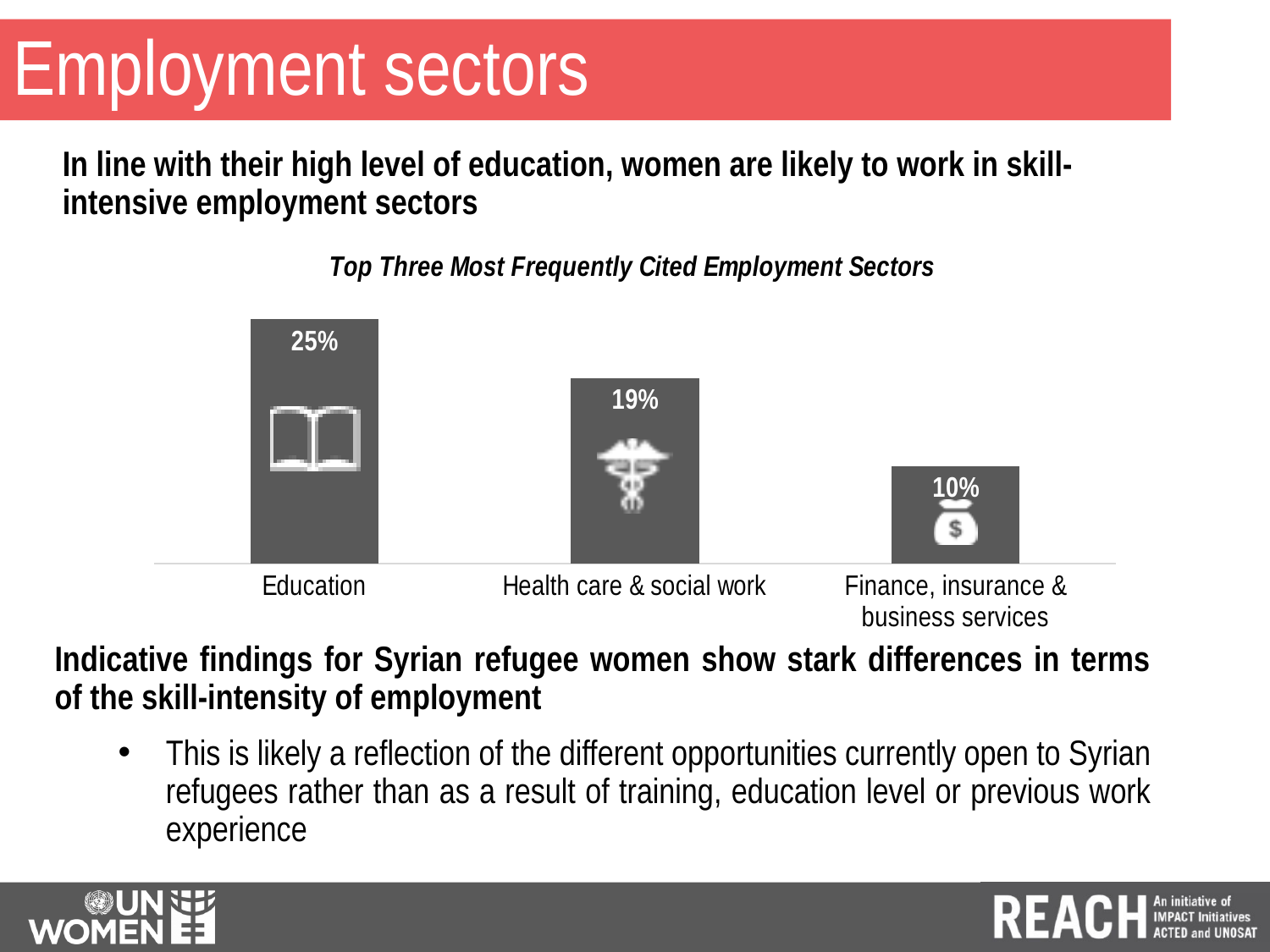
What is the value for Finance, insurance & business services? 10% Do the values rise or fall from left to right across the chart? Fall Which employment sector has the highest value? Education Which is larger, the value for Education or the value for Finance, insurance & business services? Education What is the value for Health care & social work? 19% What kind of chart is shown on the slide? Bar chart What is the difference between the values for Health care & social work and Finance, insurance & business services? 9% Which employment sector has the lowest value? Finance, insurance & business services What is the difference between the values for Education and Health care & social work? 6% How many employment sectors are shown in the chart? 3 What is the value for Education? 25% What is the title of the chart? Top Three Most Frequently Cited Employment Sectors